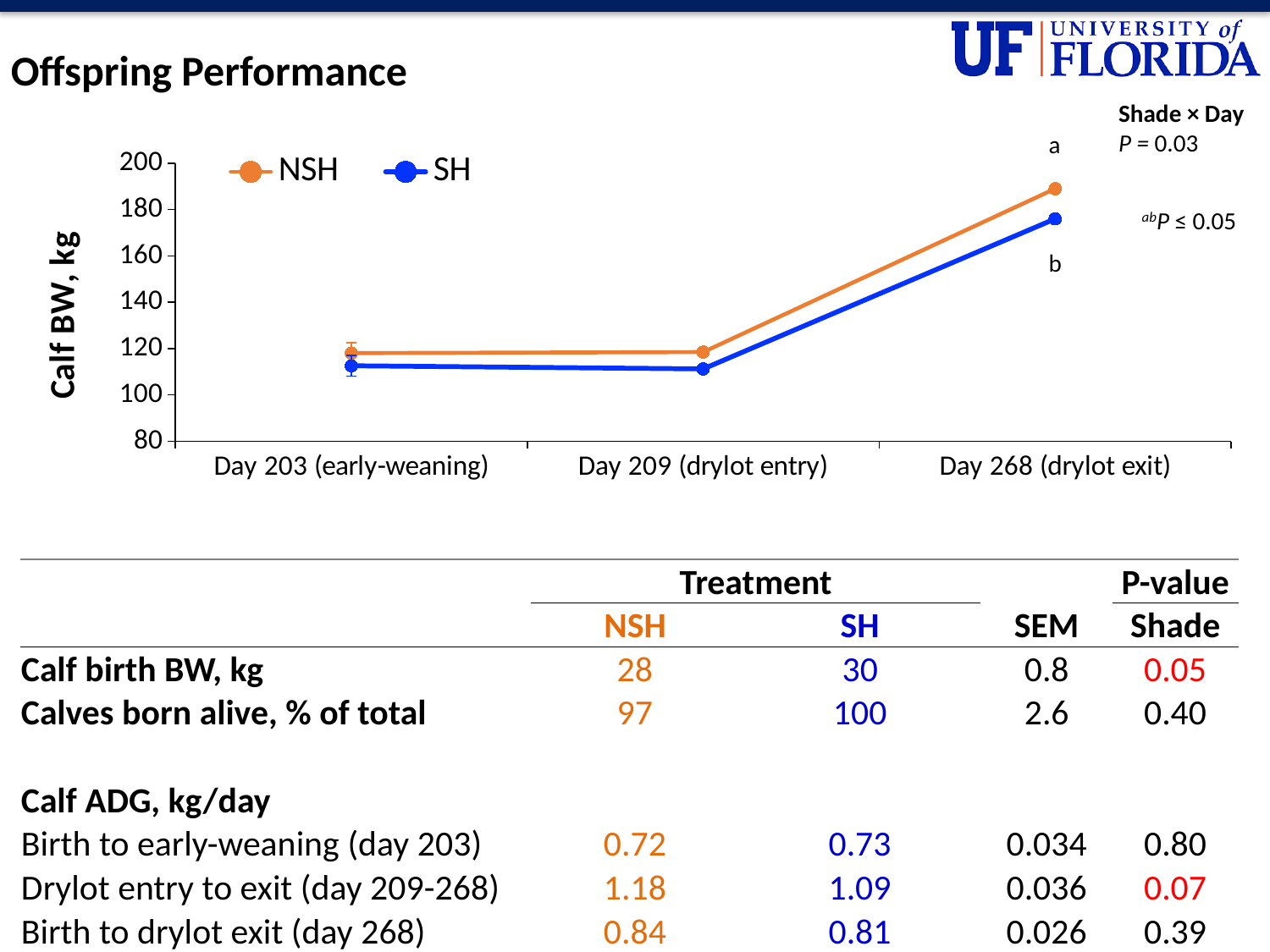
Do the calf BW values for SH rise or fall from Day 209 (drylot entry) to Day 268 (drylot exit)? rise What kind of chart is shown on the slide? line chart How many series does the chart legend list? 2 What is the label on the y axis of the chart? Calf BW, kg At which x-axis category does the NSH series reach its highest value? Day 268 (drylot exit) Which colour represents the SH series in the chart? blue Is the SH value at Day 203 (early-weaning) greater or less than 100? greater Is the NSH value at Day 209 (drylot entry) greater or less than 140? less How many day categories are shown on the x axis of the chart? 3 Is the SH value at Day 268 (drylot exit) greater or less than 180? less At Day 268 (drylot exit), which series has the higher calf BW, NSH or SH? NSH